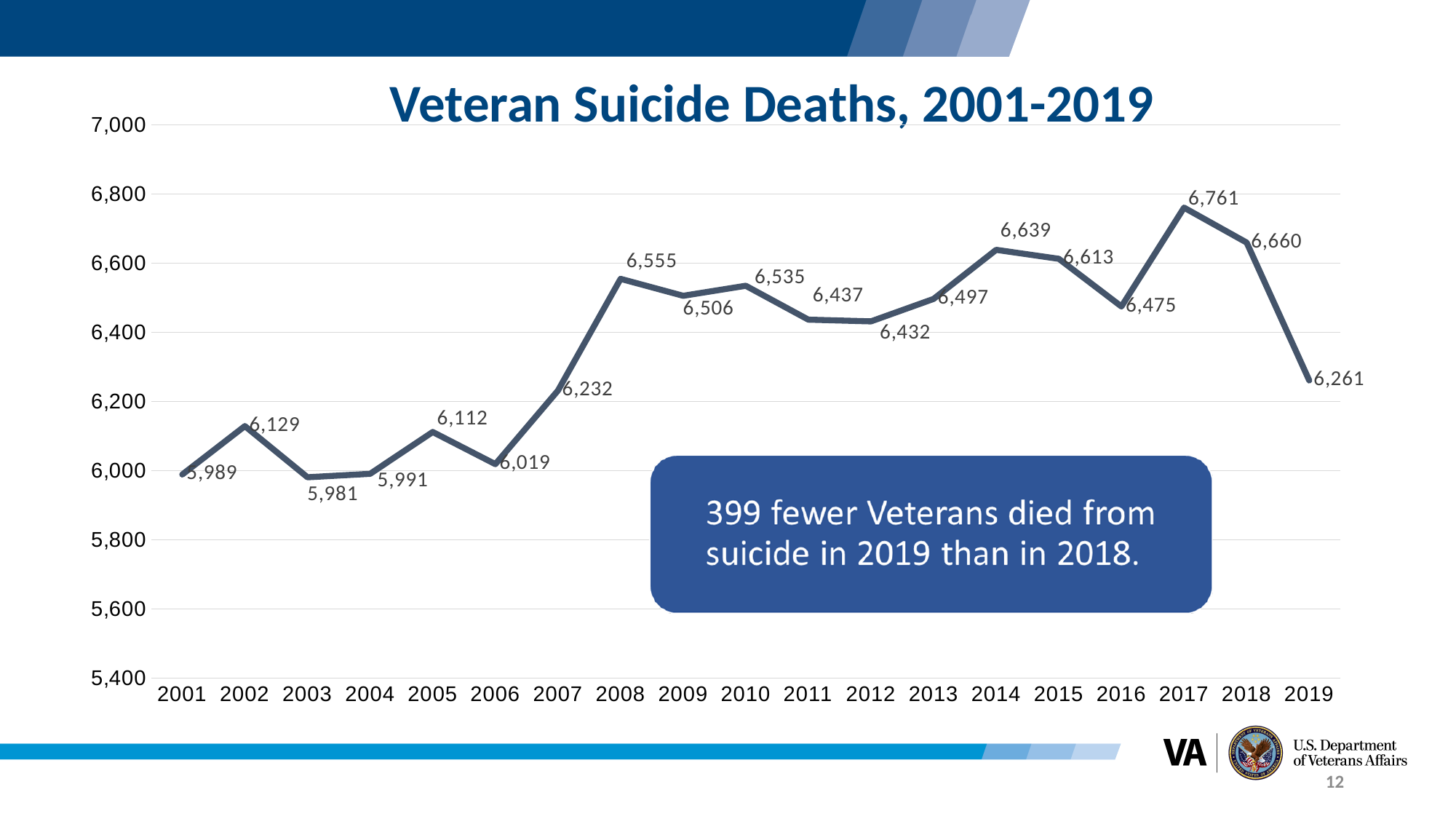
Which year had more Veteran suicide deaths, 2008 or 2014? 2014 What is the title of the chart? Veteran Suicide Deaths, 2001-2019 What kind of chart is shown on the slide? line chart What is the difference in Veteran suicide deaths between 2018 and 2019? 399 What is the number of Veteran suicide deaths in 2017? 6,761 How many years are plotted on the chart? 19 What is the difference in Veteran suicide deaths between 2017 and 2001? 772 What is the number of Veteran suicide deaths in 2019? 6,261 Which year has the lowest number of Veteran suicide deaths? 2003 What is the number of Veteran suicide deaths in 2003? 5,981 Which year has the highest number of Veteran suicide deaths? 2017 Is the value for 2007 greater or less than 6,400? less